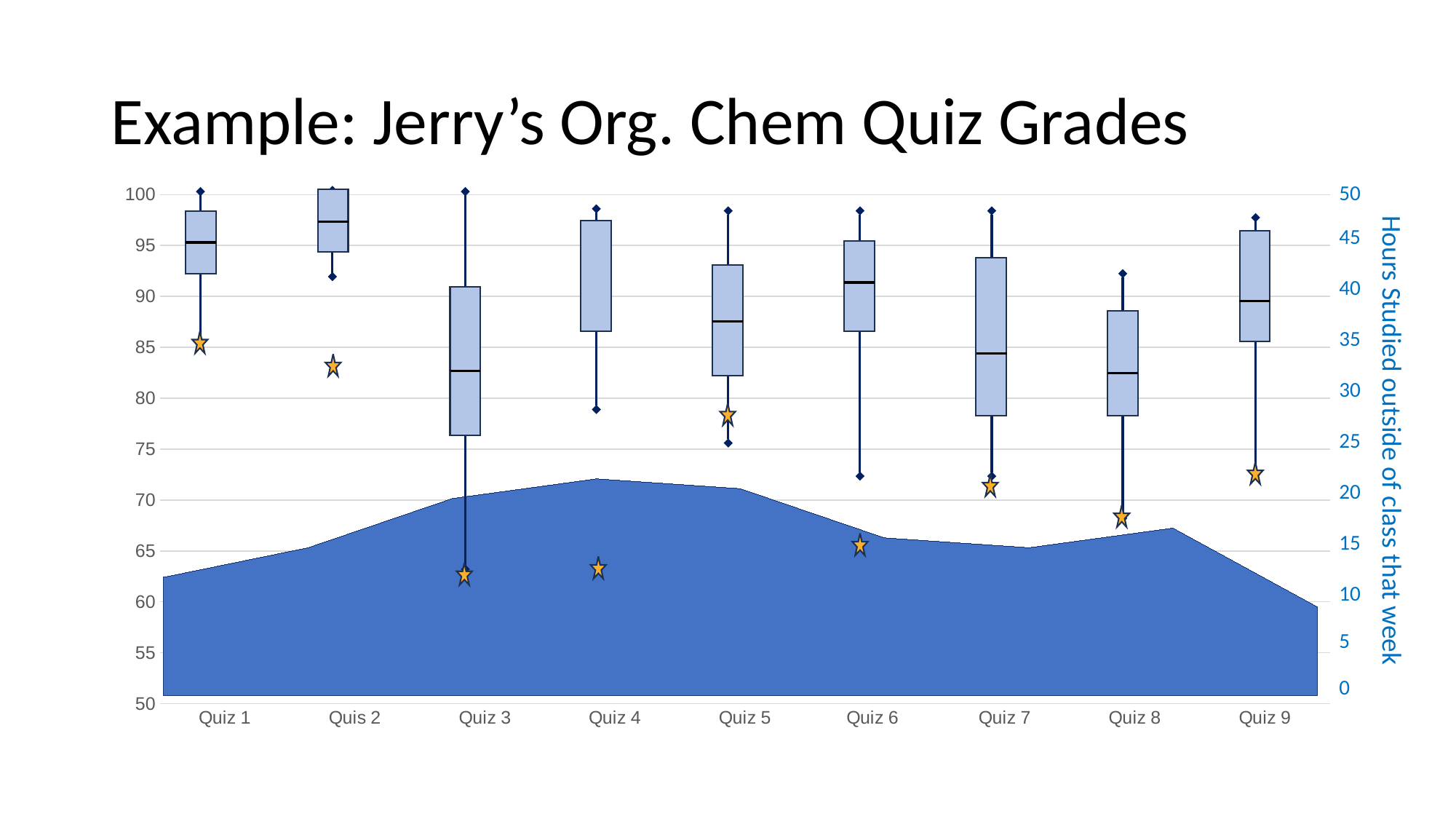
What kind of chart is used to show the quiz grade distributions on the slide? Box plot (box-and-whisker chart) Is the star marker for Quiz 1 greater or less than 80 on the left axis? greater Which quiz has the highest star marker? Quiz 1 Which star marker is higher, Quiz 1 or Quiz 3? Quiz 1 Is the hours-studied area at Quiz 4 greater or less than 20 on the right axis? greater Does the hours-studied area rise or fall from Quiz 1 to Quiz 4? rise How many quizzes are shown along the x axis of the chart? 9 What is the title of the right-hand (secondary) vertical axis? Hours Studied outside of class that week Is the star marker for Quiz 3 greater or less than 65 on the left axis? less